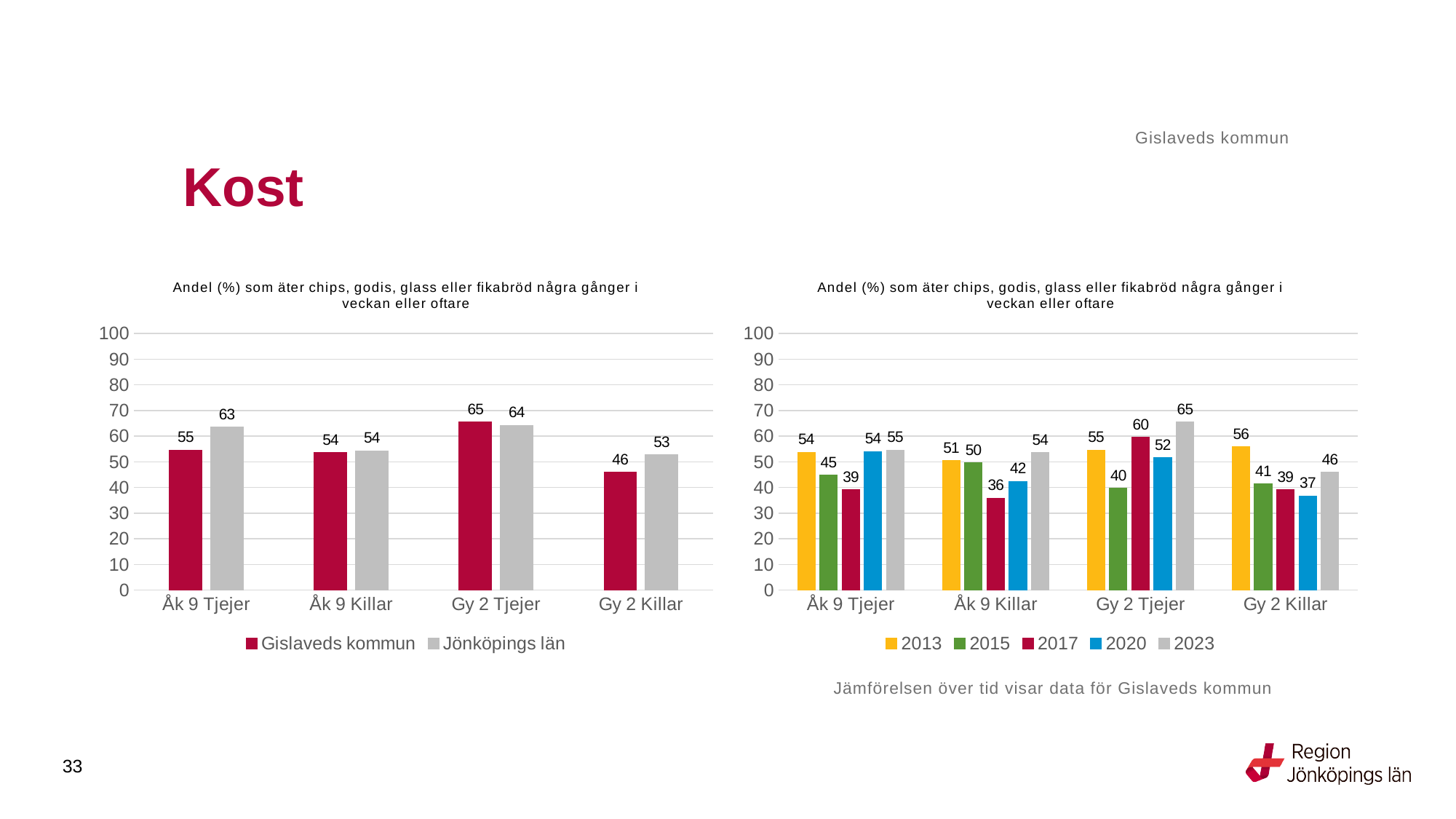
In the right chart, how many categories are shown on the x axis? 4 In the right chart, what is the value for 2023 for Gy 2 Tjejer? 65 What kind of chart is the left chart? Bar chart In the right chart, how many series does the legend list? 5 In the left chart, which category has the lowest value for Gislaveds kommun? Gy 2 Killar In the left chart, what is the difference between Jönköpings län and Gislaveds kommun for Gy 2 Killar? 7 In the left chart, what is the value for Jönköpings län for Gy 2 Killar? 53 In the right chart, is the value for 2013 or 2015 larger for Åk 9 Tjejer? 2013 In the left chart, what is the value for Gislaveds kommun for Gy 2 Tjejer? 65 In the right chart, which year has the highest value for Gy 2 Killar? 2013 In the left chart, how many series does the legend list? 2 In the right chart, what is the value for 2017 for Åk 9 Killar? 36